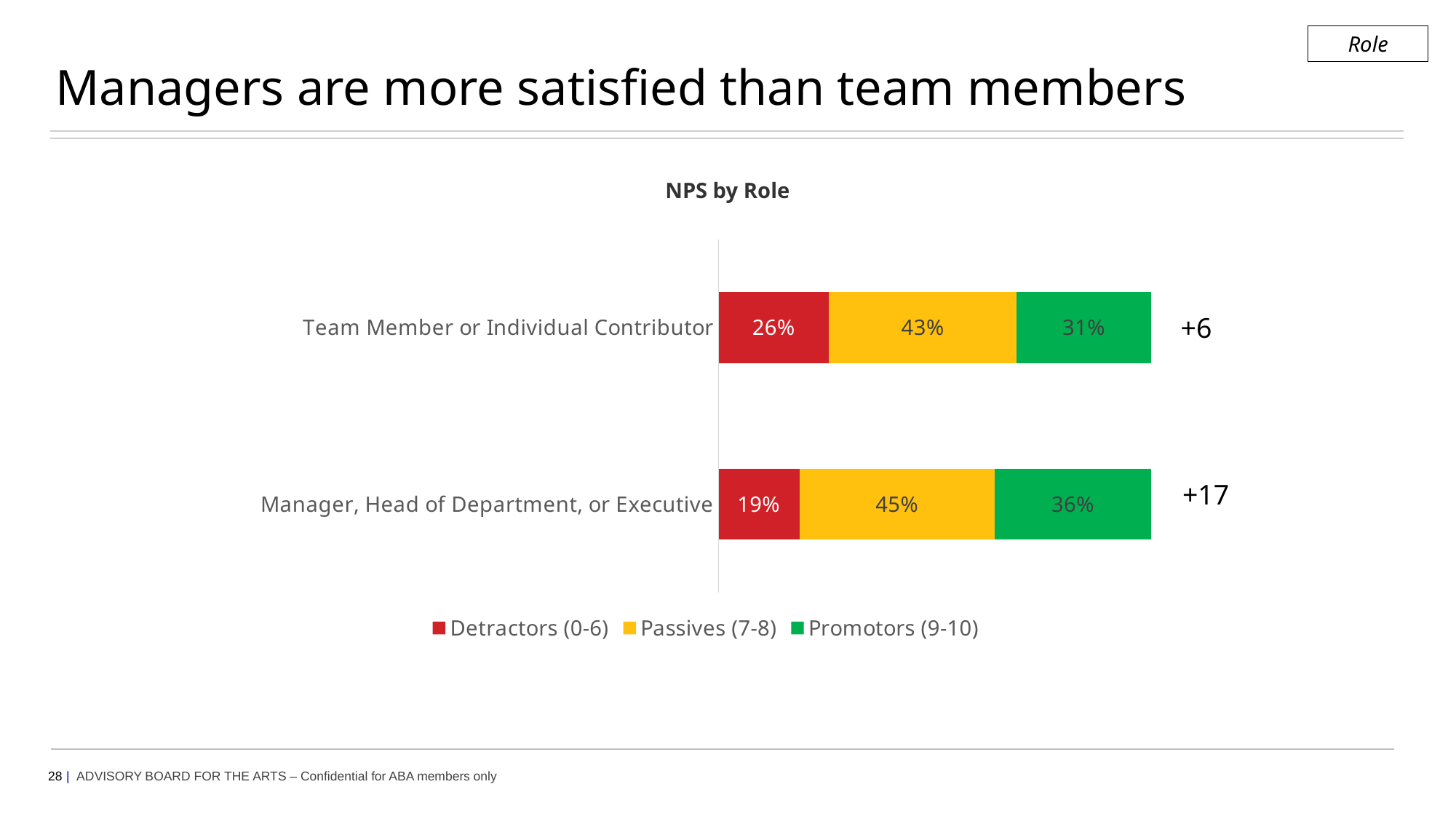
What percentage of Team Member or Individual Contributor respondents are Detractors (0-6)? 26% Which role has the higher NPS? Manager, Head of Department, or Executive What is the NPS value shown for Manager, Head of Department, or Executive? +17 What is the title of the chart? NPS by Role Which role has the higher share of Detractors (0-6)? Team Member or Individual Contributor What is the total of the stacked bar for Manager, Head of Department, or Executive? 100% How many series does the legend list? 3 How many role categories are plotted in the chart? 2 What percentage of Team Member or Individual Contributor respondents are Passives (7-8)? 43% What percentage of Manager, Head of Department, or Executive respondents are Promotors (9-10)? 36% What kind of chart is shown on the slide? Stacked bar chart What is the difference in the Promotors (9-10) share between Manager, Head of Department, or Executive and Team Member or Individual Contributor? 5%